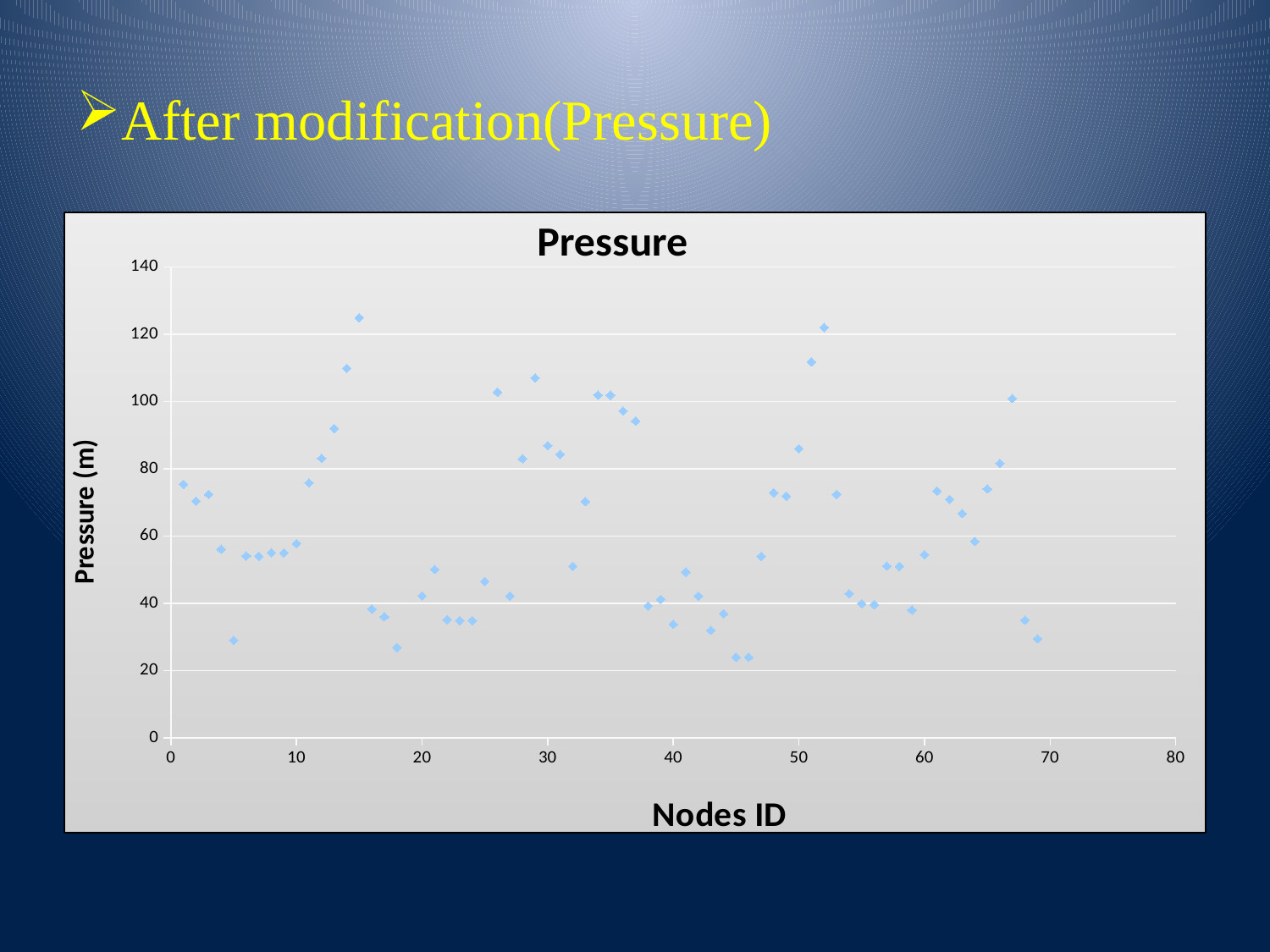
Is the pressure value for node ID 29 greater or less than 100? greater Is the pressure value for node ID 1 greater or less than 60? greater Is the pressure value for node ID 52 greater or less than 100? greater What is the label of the vertical axis of the chart? Pressure (m) What kind of chart is shown on the slide? scatter chart What is the title of the chart? Pressure